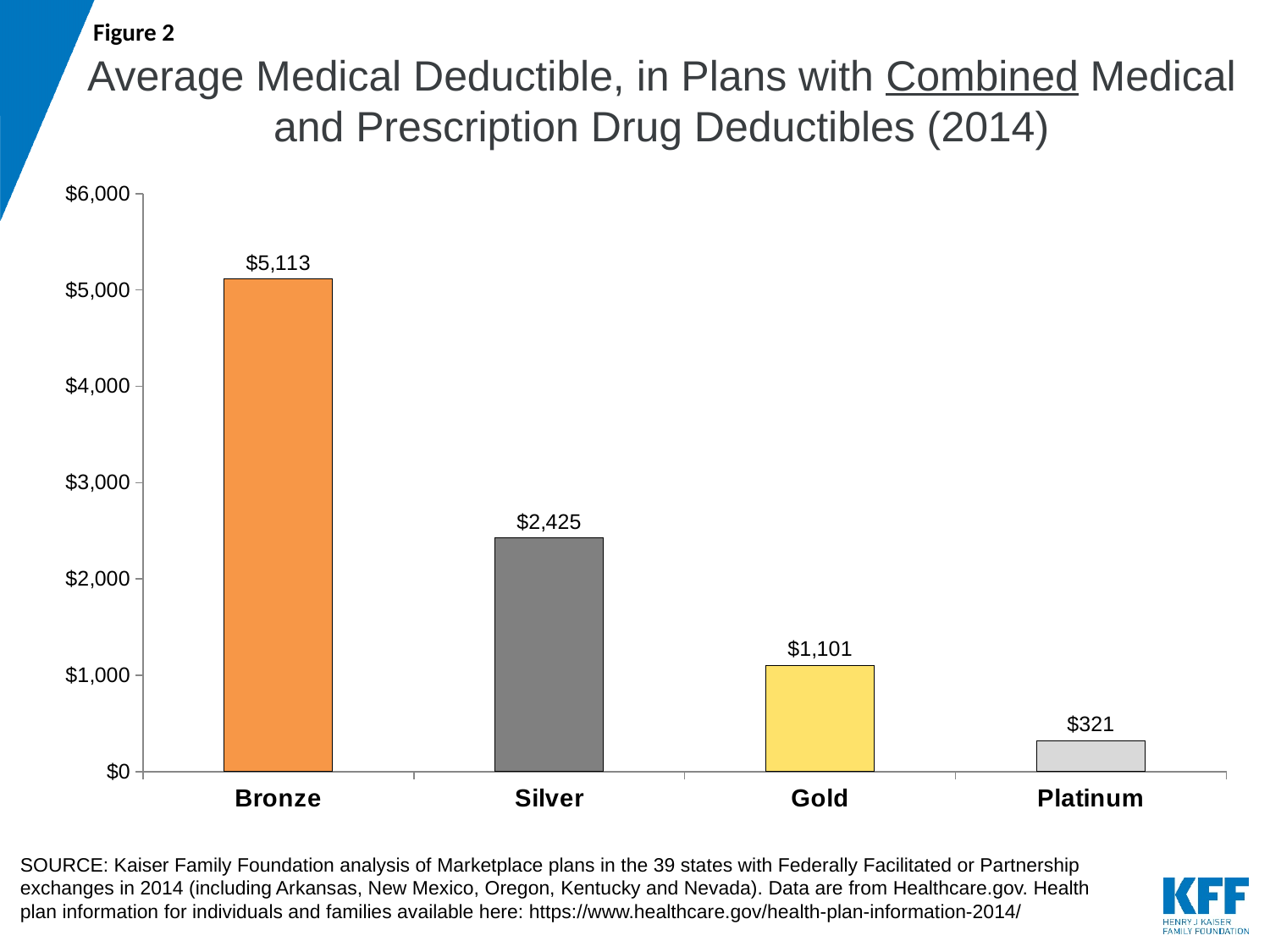
What kind of chart is shown on the slide? Bar chart What is the average medical deductible for Silver plans? $2,425 What is the average medical deductible for Platinum plans? $321 Which has a larger average medical deductible, Silver or Gold? Silver What is the difference between the Gold and Platinum average medical deductibles? $780 Which plan type has the highest average medical deductible? Bronze How many plan types are shown on the chart? 4 What is the average medical deductible for Gold plans? $1,101 What is the average medical deductible for Bronze plans? $5,113 Which plan type has the lowest average medical deductible? Platinum What is the difference between the Bronze and Silver average medical deductibles? $2,688 Do the values rise or fall moving from Bronze to Platinum along the x axis? Fall